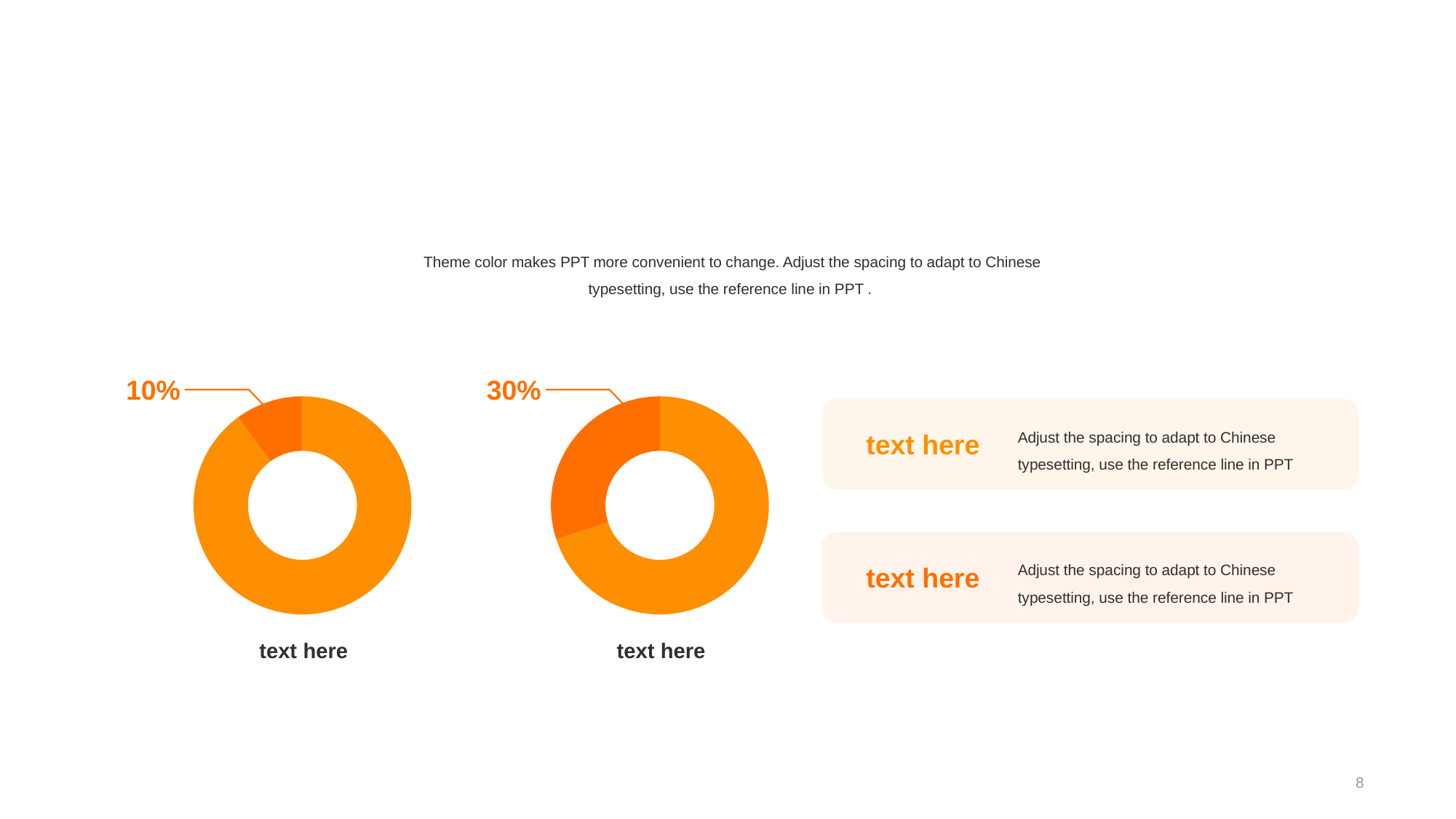
How many slices does the right doughnut chart have? 2 On the right doughnut chart, what percentage is shown for the highlighted (darker orange) slice? 30% On the left doughnut chart, what percentage is shown for the highlighted (darker orange) slice? 10% What kind of chart is the left chart on the slide? Doughnut chart How many slices does the left doughnut chart have? 2 On the left doughnut chart, is the labelled slice the larger or the smaller of the two slices? The smaller What kind of chart is the right chart on the slide? Doughnut chart How many doughnut charts are shown on the slide? 2 What is the caption shown below the left doughnut chart? text here Which chart has the larger labelled slice, the left doughnut chart or the right doughnut chart? The right doughnut chart What is the difference between the labelled slice of the right doughnut chart and the labelled slice of the left doughnut chart? 20%